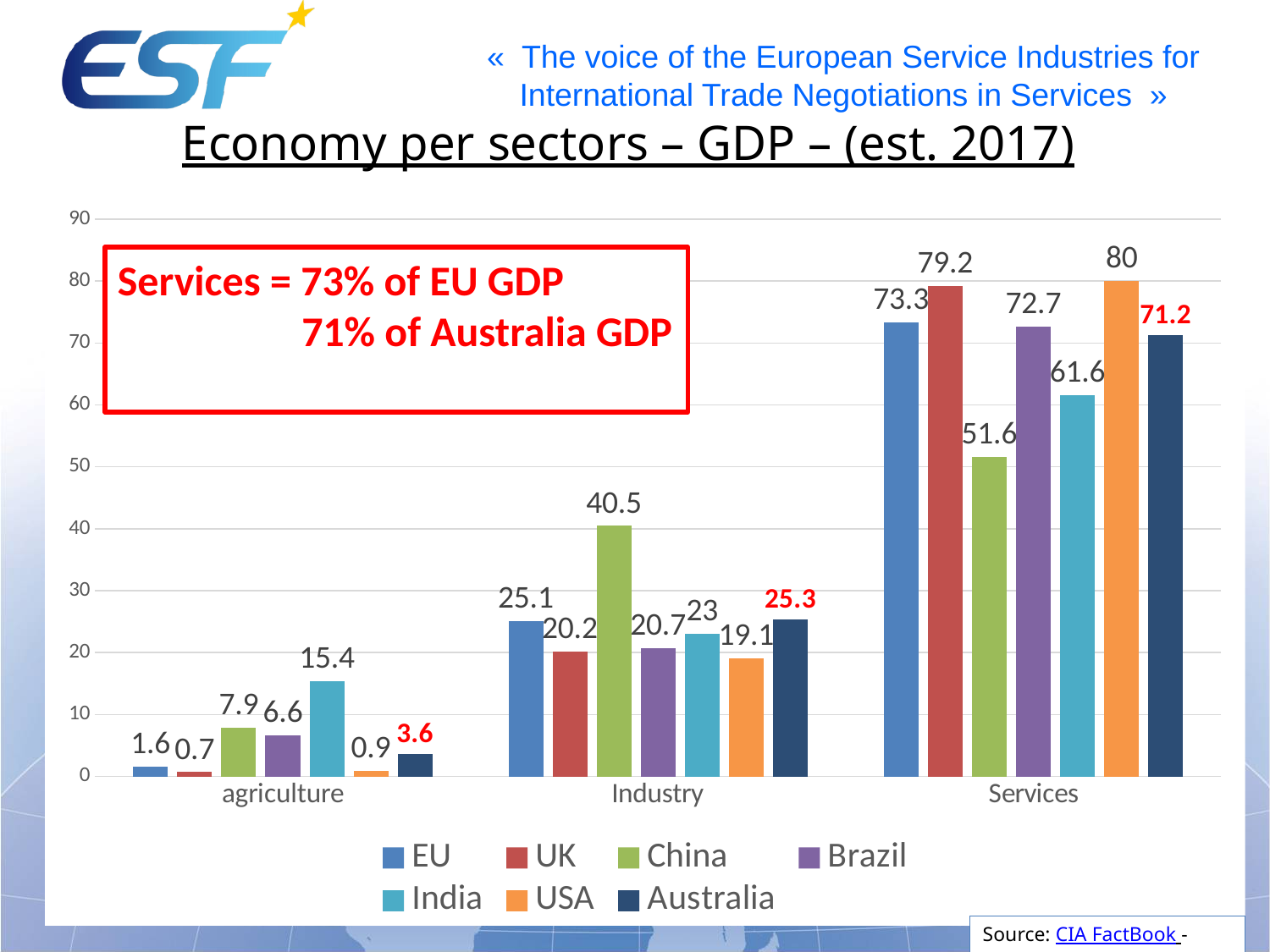
How many categories are shown on the x axis? 3 What is the difference between the UK and EU values in the Services category? 5.9 Is the value for China in the Services category greater or less than 60? less What is the value for India in the agriculture category? 15.4 Which series has the highest value in the Services category? USA What kind of chart is shown on the slide? bar chart Which is larger in the Industry category, the value for EU or the value for UK? EU What is the value for Australia in the Services category? 71.2 How many series does the legend list? 7 Which series has the lowest value in the agriculture category? UK What is the value for China in the Industry category? 40.5 What is the title of the chart? Economy per sectors – GDP – (est. 2017)